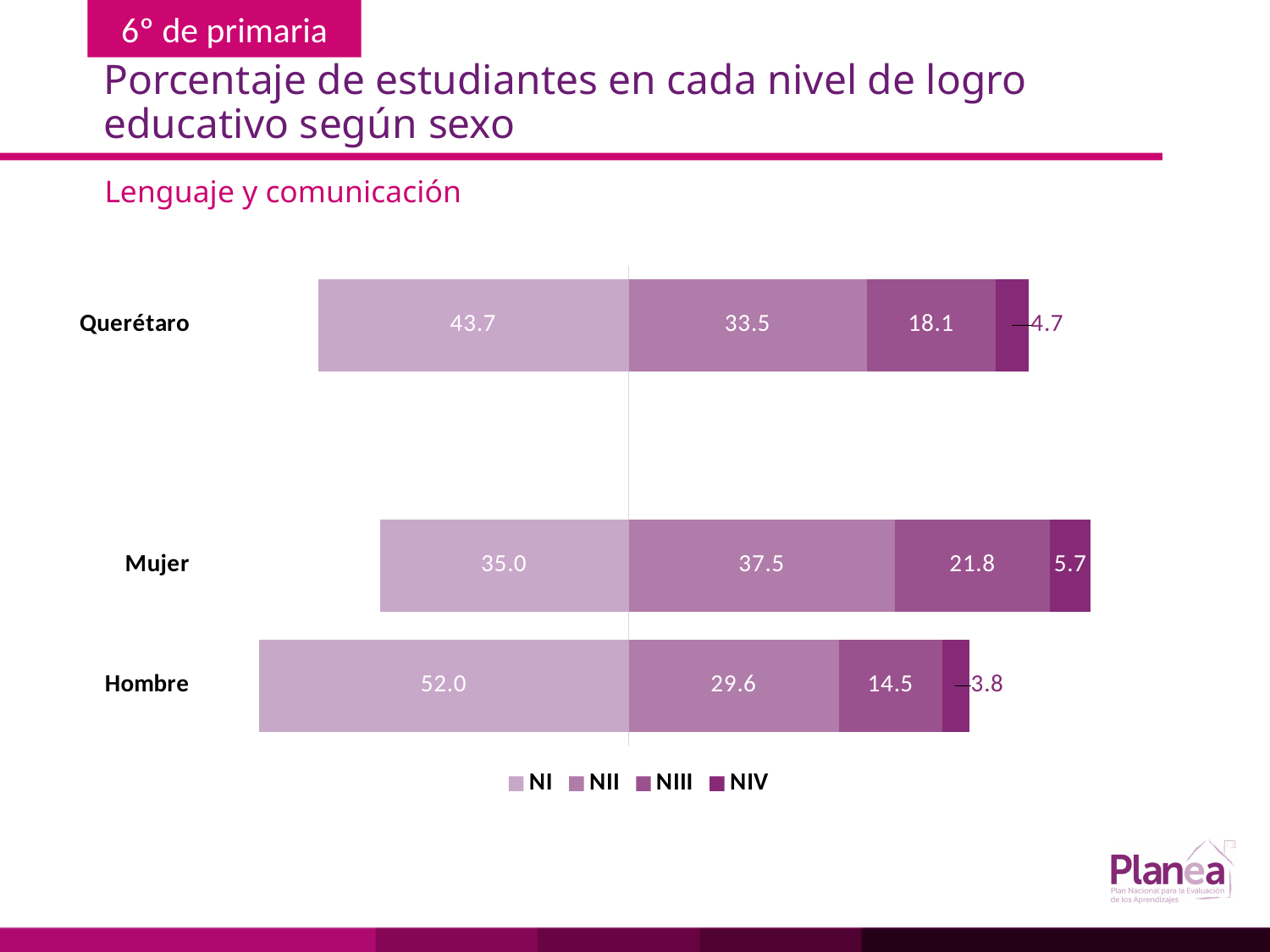
What is the NIV value for Mujer? 5.7 What kind of chart is shown on the slide? Stacked bar chart How many categories are shown on the chart? 3 What is the NII value for Querétaro? 33.5 What is the NI value for Hombre? 52.0 What is the total of the stacked bar for Mujer? 100.0 Which is larger, the NIII value for Mujer or the NIII value for Querétaro? Mujer What is the NIII value for Hombre? 14.5 Which category has the highest NI value? Hombre How many series does the legend list? 4 What is the difference between the NI values for Hombre and Mujer? 17.0 Which category has the lowest NIV value? Hombre